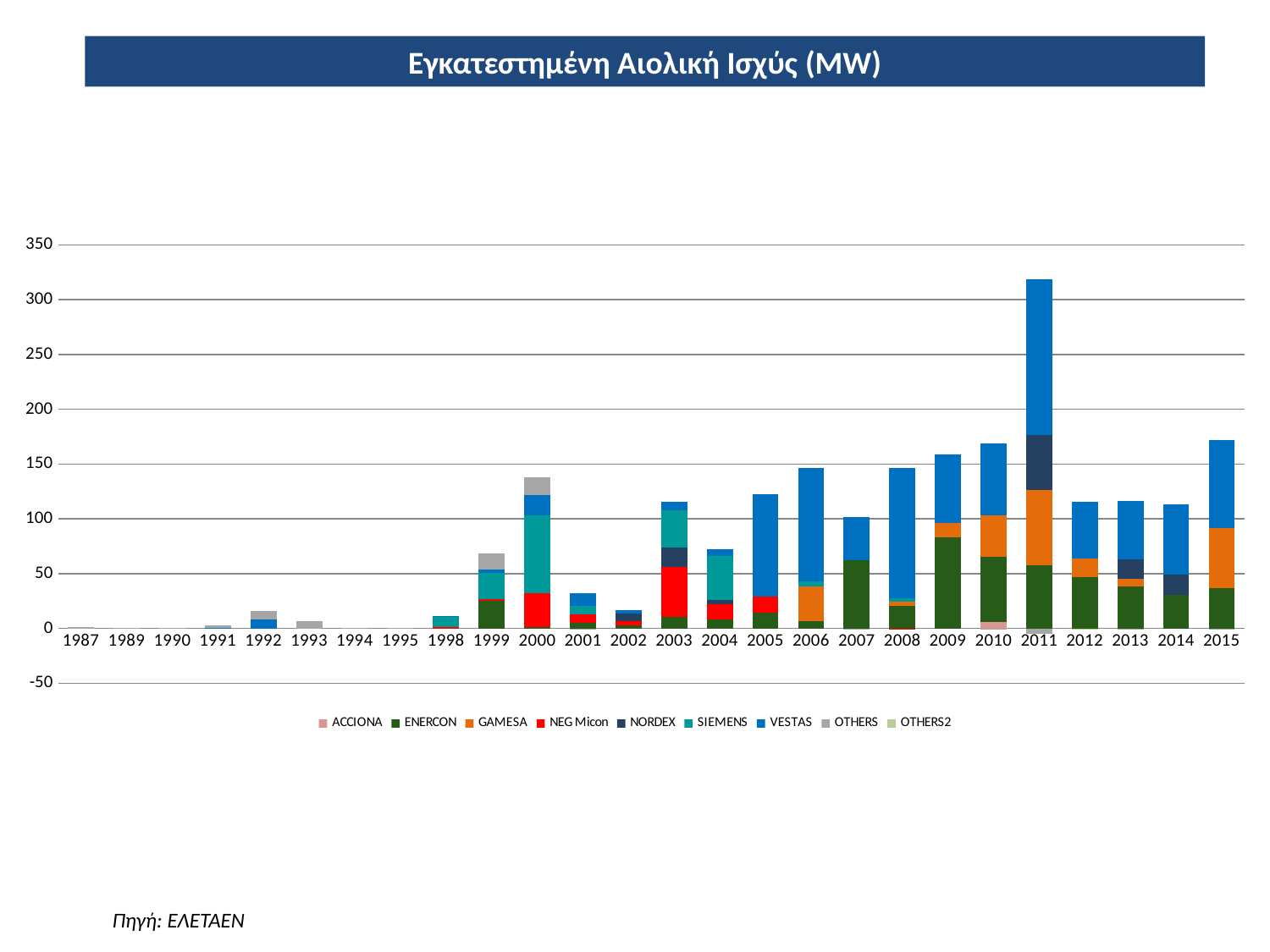
What is the title of the chart? Εγκατεστημένη Αιολική Ισχύς (MW) Is the total value for 2011 greater or less than 300? greater Which series is shown in red in the legend? NEG Micon Which year has the larger total bar, 2015 or 2012? 2015 What kind of chart is shown on the slide? Stacked bar chart Which year has the tallest bar? 2011 Is the total value for 2009 greater or less than 150? greater How many years are shown on the x axis? 26 Is the total value for 2000 greater or less than 150? less Which year has the larger total bar, 2006 or 2007? 2006 How many series does the legend list? 9